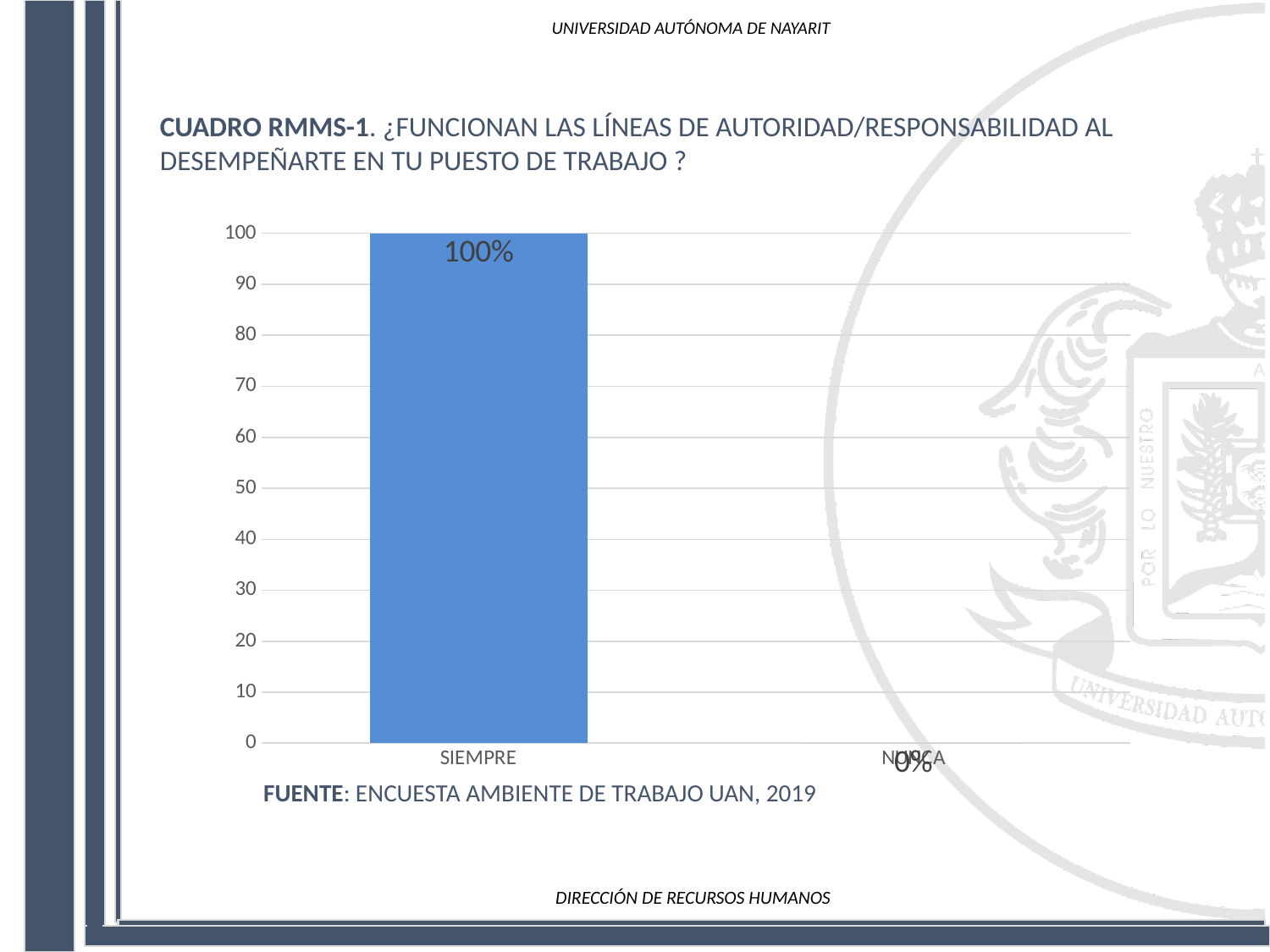
What is the highest value shown on the vertical axis? 100 What is the difference between the values for SIEMPRE and NUNCA? 100% Which category has the highest value? SIEMPRE What source is cited below the chart? ENCUESTA AMBIENTE DE TRABAJO UAN, 2019 Which category has the lowest value? NUNCA How many categories are shown on the x axis? 2 Which is larger, the value for SIEMPRE or the value for NUNCA? SIEMPRE What is the value for SIEMPRE? 100% Is the value for SIEMPRE greater or less than 50? greater What kind of chart is shown on the slide? bar chart What is the value for NUNCA? 0%